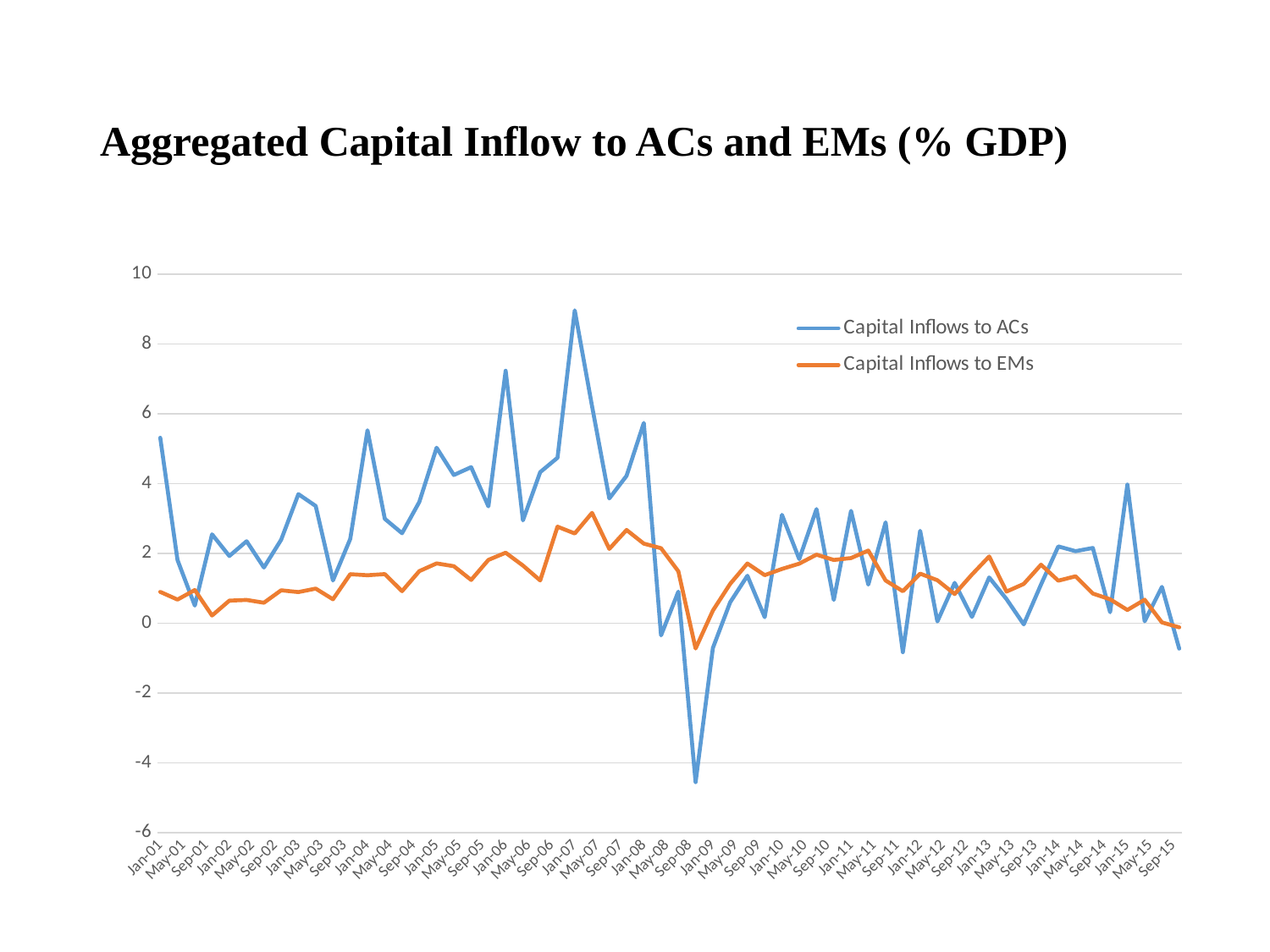
Is the value for Capital Inflows to ACs at Jan-07 greater or less than 8? greater What kind of chart is shown on the slide? line chart Is the value for Capital Inflows to EMs at Sep-08 greater or less than 0? less Is the value for Capital Inflows to ACs at Sep-08 greater or less than -4? less How many series does the legend list? 2 At Jan-07, which series has the higher value, Capital Inflows to ACs or Capital Inflows to EMs? Capital Inflows to ACs Does the Capital Inflows to EMs line rise or fall between Jan-08 and Sep-08? fall At Sep-08, which series has the higher value, Capital Inflows to ACs or Capital Inflows to EMs? Capital Inflows to EMs What colour is the line for Capital Inflows to EMs? orange Which series reaches the highest value on the chart? Capital Inflows to ACs Which series reaches the lowest value on the chart? Capital Inflows to ACs What is the title of the chart? Aggregated Capital Inflow to ACs and EMs (% GDP)